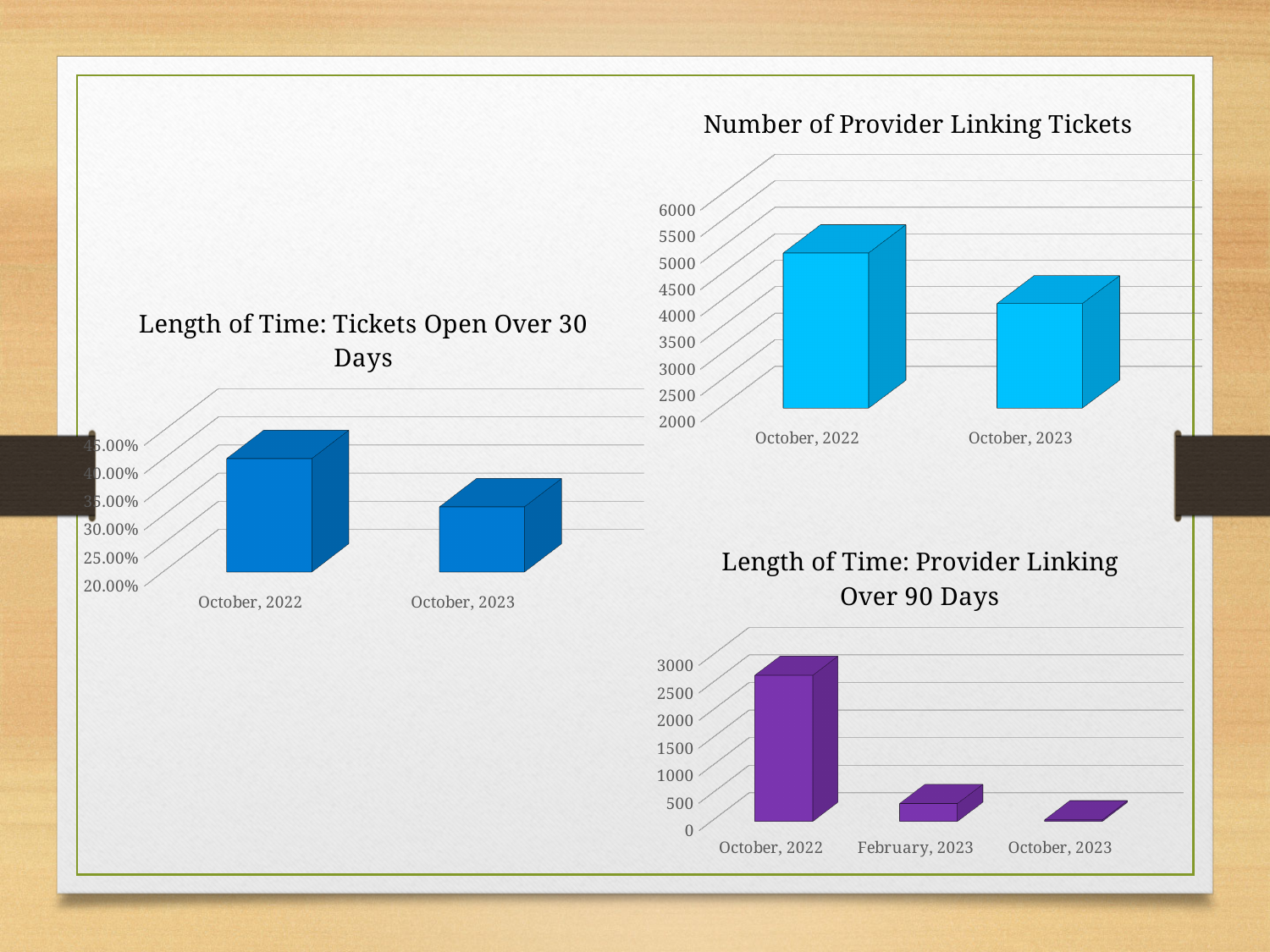
In the "Length of Time: Provider Linking Over 90 Days" chart, is the value for February, 2023 greater or less than 1000? less In the "Length of Time: Provider Linking Over 90 Days" chart, how many categories are plotted? 3 In the "Number of Provider Linking Tickets" chart, is the value for October, 2022 greater or less than 4000? greater In the "Length of Time: Provider Linking Over 90 Days" chart, do the values rise or fall from October, 2022 to October, 2023? fall In the "Length of Time: Tickets Open Over 30 Days" chart, which is larger, October, 2022 or October, 2023? October, 2022 In the "Number of Provider Linking Tickets" chart, which category has the highest value? October, 2022 In the "Length of Time: Provider Linking Over 90 Days" chart, which category has the lowest value? October, 2023 In the "Length of Time: Tickets Open Over 30 Days" chart, how many categories are plotted? 2 What kind of chart is "Number of Provider Linking Tickets"? bar chart In the "Number of Provider Linking Tickets" chart, is the value for October, 2023 greater or less than 5000? less How many charts are shown on the slide? 3